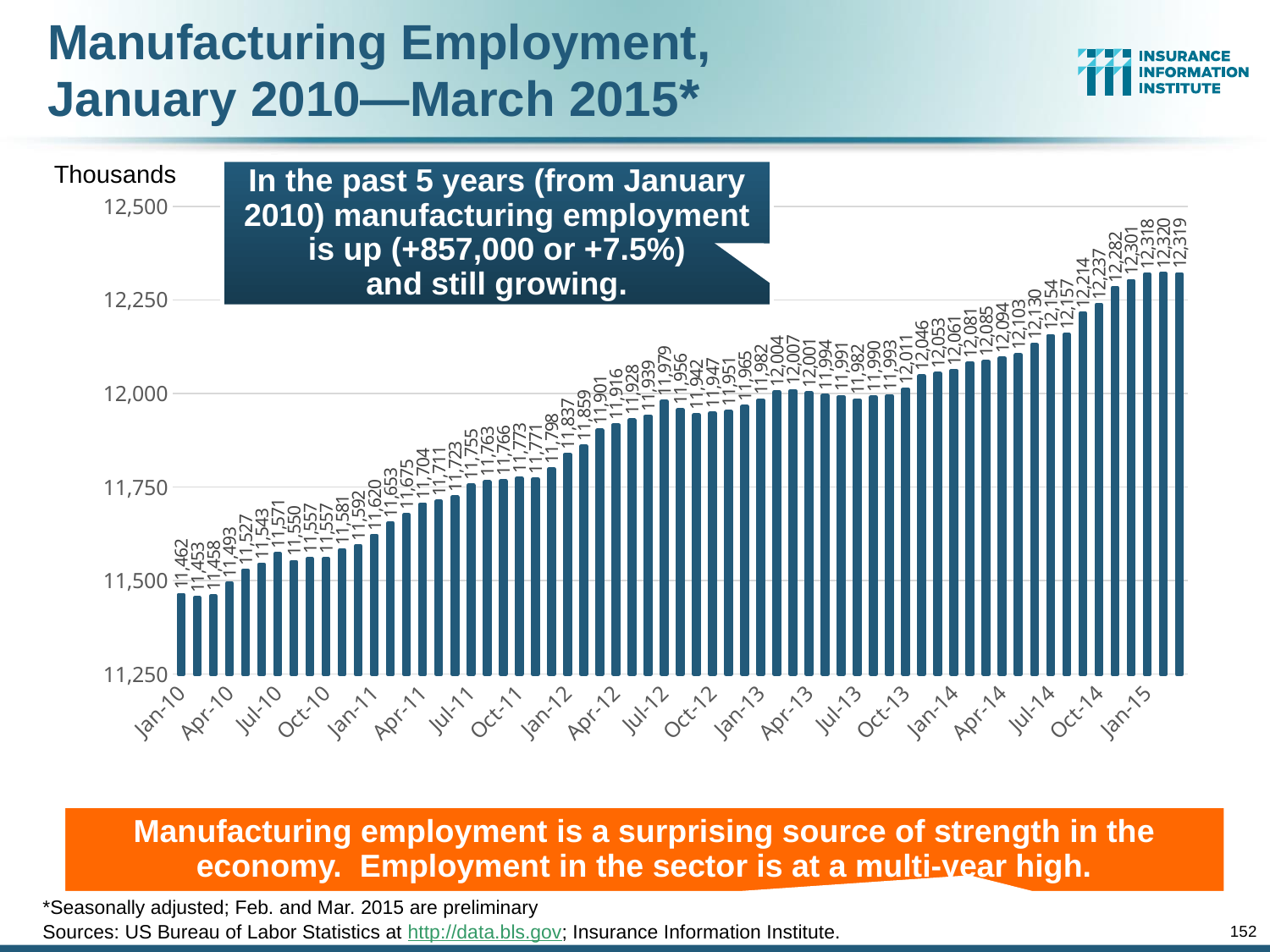
What is the difference between the Mar-15 value (12,319) and the Jan-10 value (11,462)? 857 Do the values generally rise or fall from Jan-10 to Mar-15? Rise Which is larger, the value for Jan-12 or the value for Jan-14? Jan-14 What unit label is shown above the vertical axis? Thousands What kind of chart is shown on the slide? Bar chart What is the manufacturing employment value for Jan-13? 11,982 What is the manufacturing employment value for the last bar, Mar-15? 12,319 What is the manufacturing employment value for Oct-14? 12,237 How many monthly bars are plotted on the chart? 63 Is the value for Jan-15 greater or less than 12,250? greater Is the value for Jan-10 greater or less than 11,500? less What is the manufacturing employment value for Jan-10? 11,462